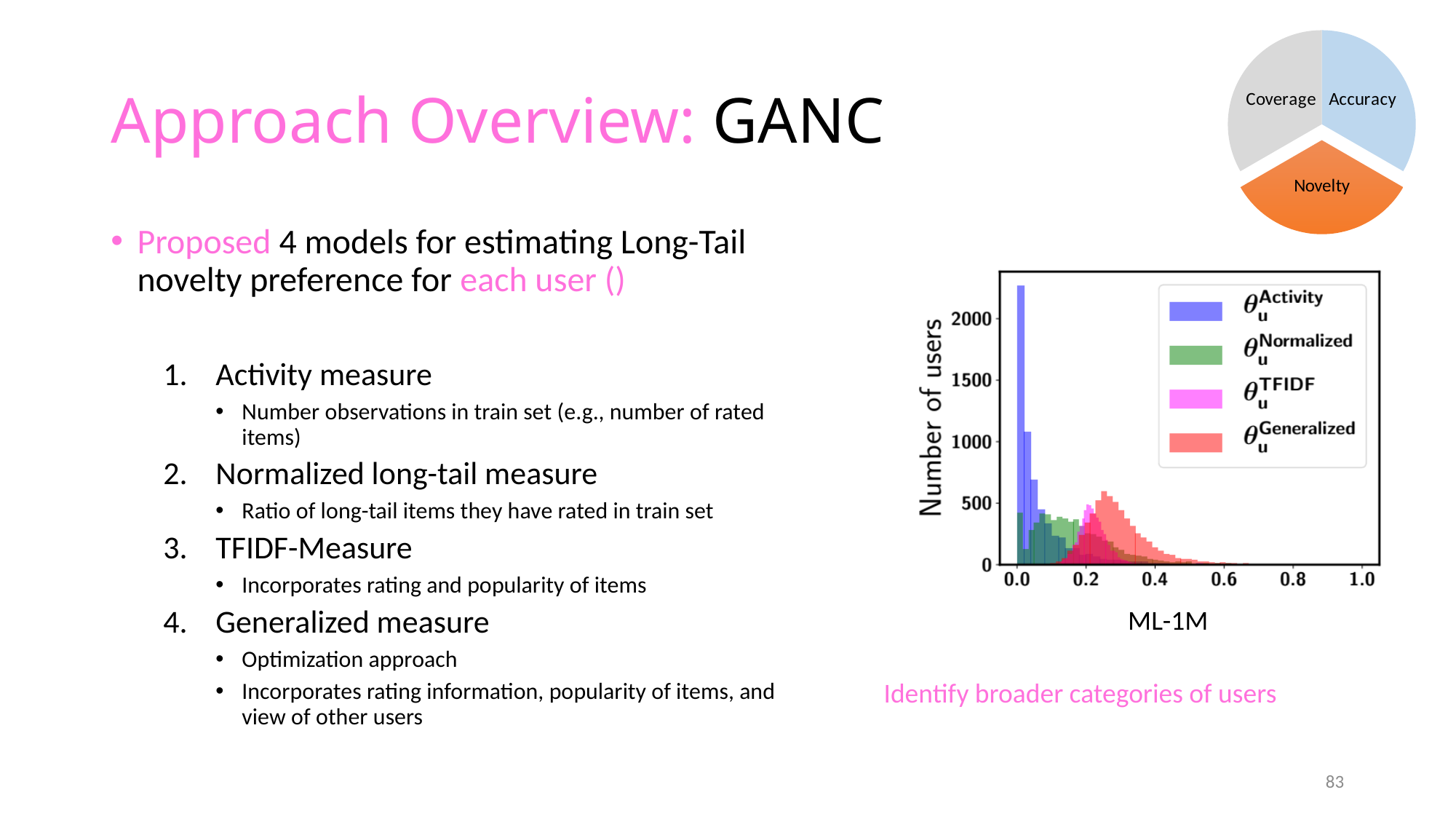
Which slice of the top-right pie chart is coloured orange? Novelty In the ML-1M chart, which series has the tallest bar overall? Activity In the ML-1M chart, is the tallest Activity bar greater or less than 2000 users? greater In the ML-1M chart, is the tallest Generalized (red) bar greater or less than 1000 users? less In the ML-1M chart, what is the highest tick value shown on the x axis? 1.0 What is the y-axis label of the ML-1M chart? Number of users How many series does the legend of the ML-1M chart list? 4 What kind of chart is the ML-1M chart on the right of the slide? histogram (bar chart) What kind of chart is shown in the top-right corner of the slide? pie chart How many slices does the pie chart in the top-right corner have? 3 In the ML-1M chart, is the tallest Normalized (green) bar greater or less than 500 users? less